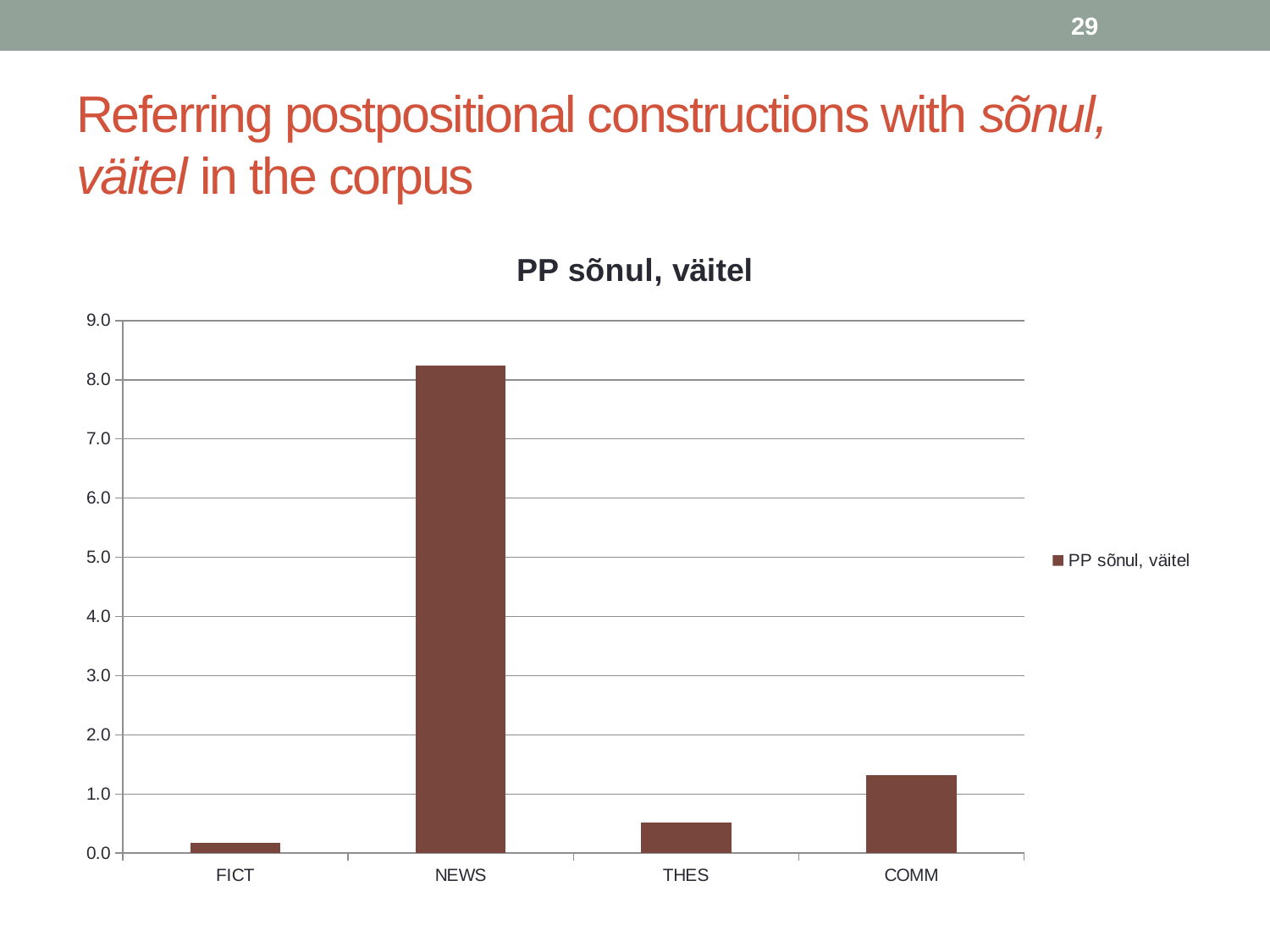
What is the name of the series shown in the legend? PP sõnul, väitel Is the value for COMM greater or less than 1.0? greater What type of chart is shown on the slide? bar chart Which category has the lowest value? FICT Is the value for NEWS greater or less than 8.0? greater Which category has the highest value? NEWS How many series does the legend list? 1 Is the value for THES greater or less than 1.0? less How many categories are shown on the x axis? 4 What is the title of the chart? PP sõnul, väitel Which is larger, the value for FICT or the value for NEWS? NEWS Which is larger, the value for COMM or the value for THES? COMM